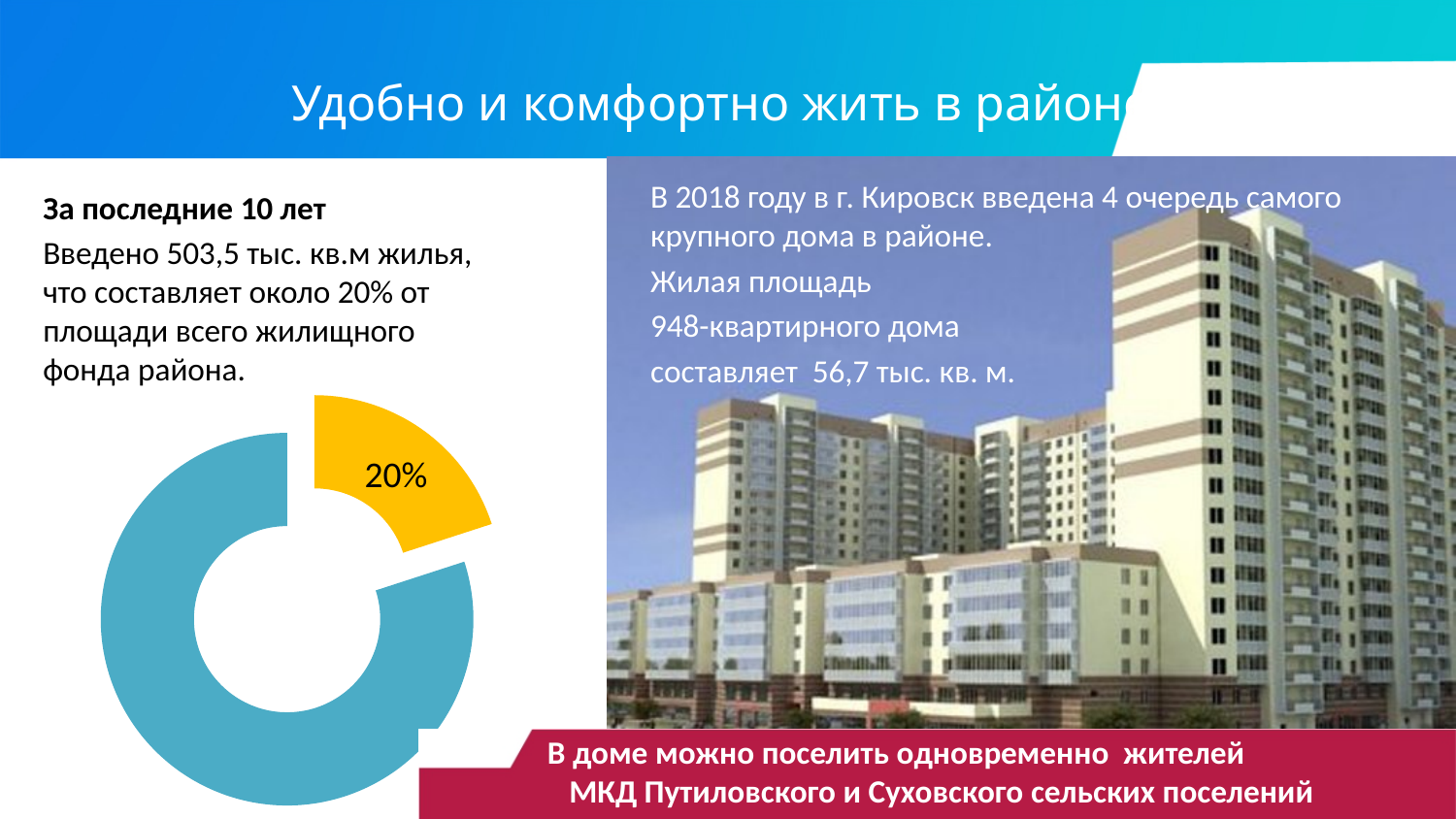
What share of the doughnut chart does the labelled slice represent? 20% Which slice of the doughnut chart is larger, the yellow one or the blue one? The blue one What colour is the slice labelled 20% in the doughnut chart? Yellow Does the doughnut chart have a legend? No Is the share of the blue slice in the doughnut chart greater or less than 50%? greater Which slice of the doughnut chart is the smallest? The yellow slice (20%) How many slices does the doughnut chart have? 2 What percentage is printed on the yellow slice of the doughnut chart? 20% What kind of chart is shown on the slide? Doughnut chart